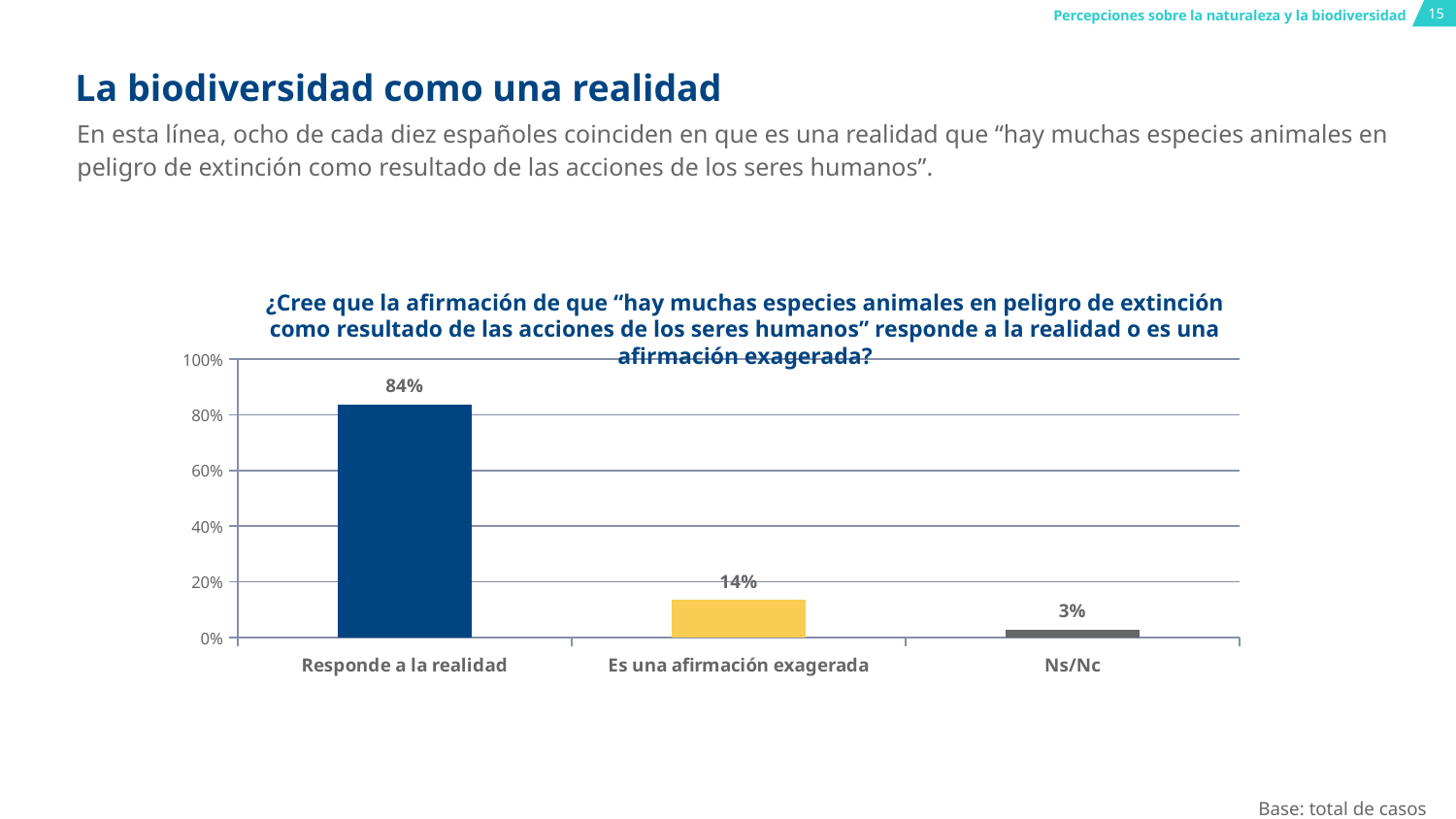
Which category has the lowest value? Ns/Nc What is the value for "Ns/Nc"? 3% What kind of chart is shown on the slide? Bar chart What is the value for "Responde a la realidad"? 84% What is the value for "Es una afirmación exagerada"? 14% Is the value for "Responde a la realidad" greater or less than 80%? greater What is the difference between "Responde a la realidad" and "Es una afirmación exagerada"? 70 percentage points What is the difference between "Es una afirmación exagerada" and "Ns/Nc"? 11 percentage points How many categories are shown on the x axis? 3 Which category has the highest value? Responde a la realidad What colour is the bar for "Responde a la realidad"? Dark blue Which is larger, the value for "Es una afirmación exagerada" or the value for "Ns/Nc"? Es una afirmación exagerada